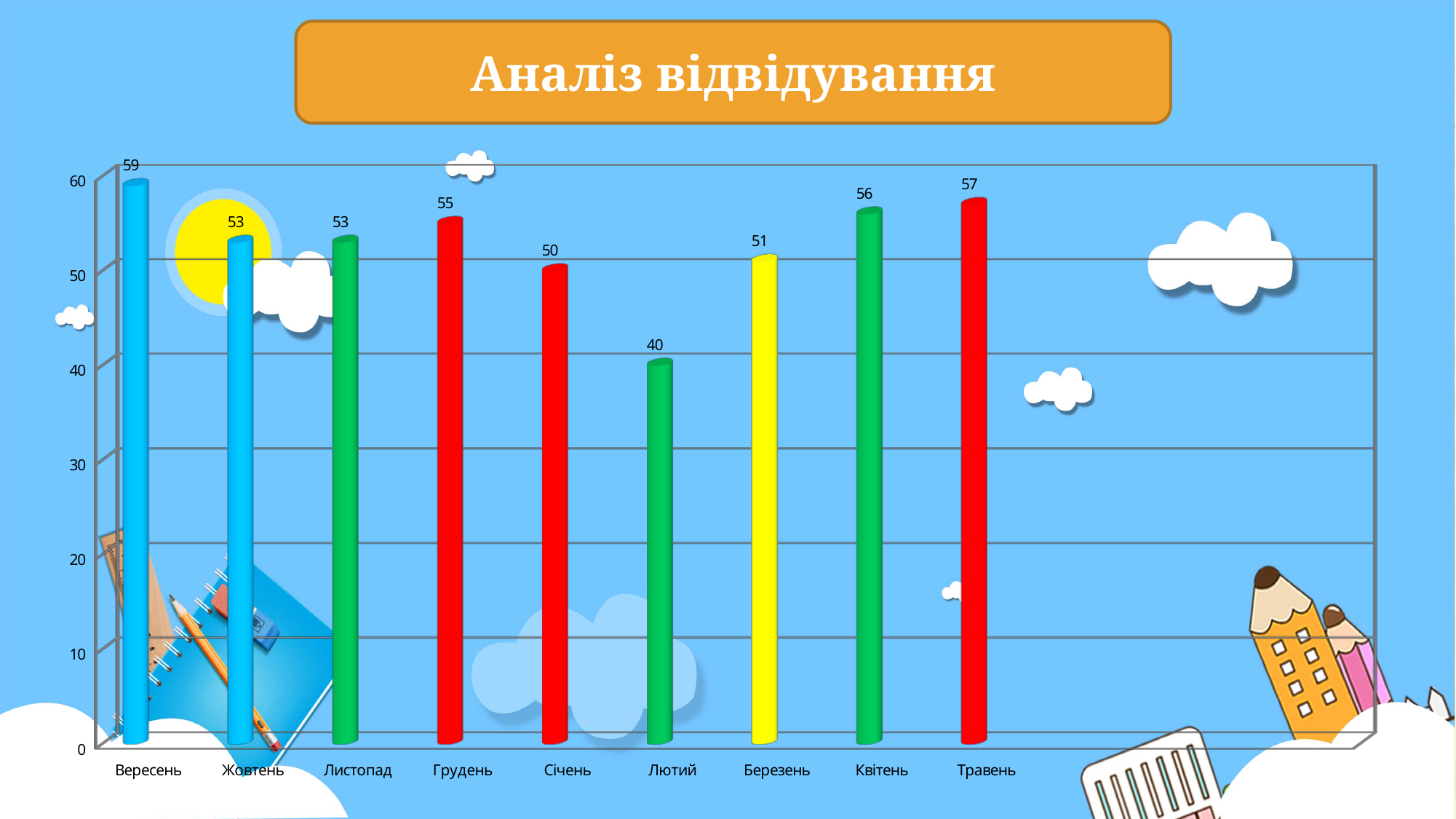
What kind of chart is shown on the slide? bar chart What is the value for Травень? 57 How many months are shown on the chart? 9 Is the value for Квітень greater or less than 50? greater What is the title of the slide? Аналіз відвідування What is the value for Лютий? 40 Which is larger, the value for Грудень or the value for Січень? Грудень What is the value for Вересень? 59 What is the difference between the values for Вересень and Лютий? 19 What is the value for Березень? 51 Which month has the lowest value? Лютий Which month has the highest value? Вересень